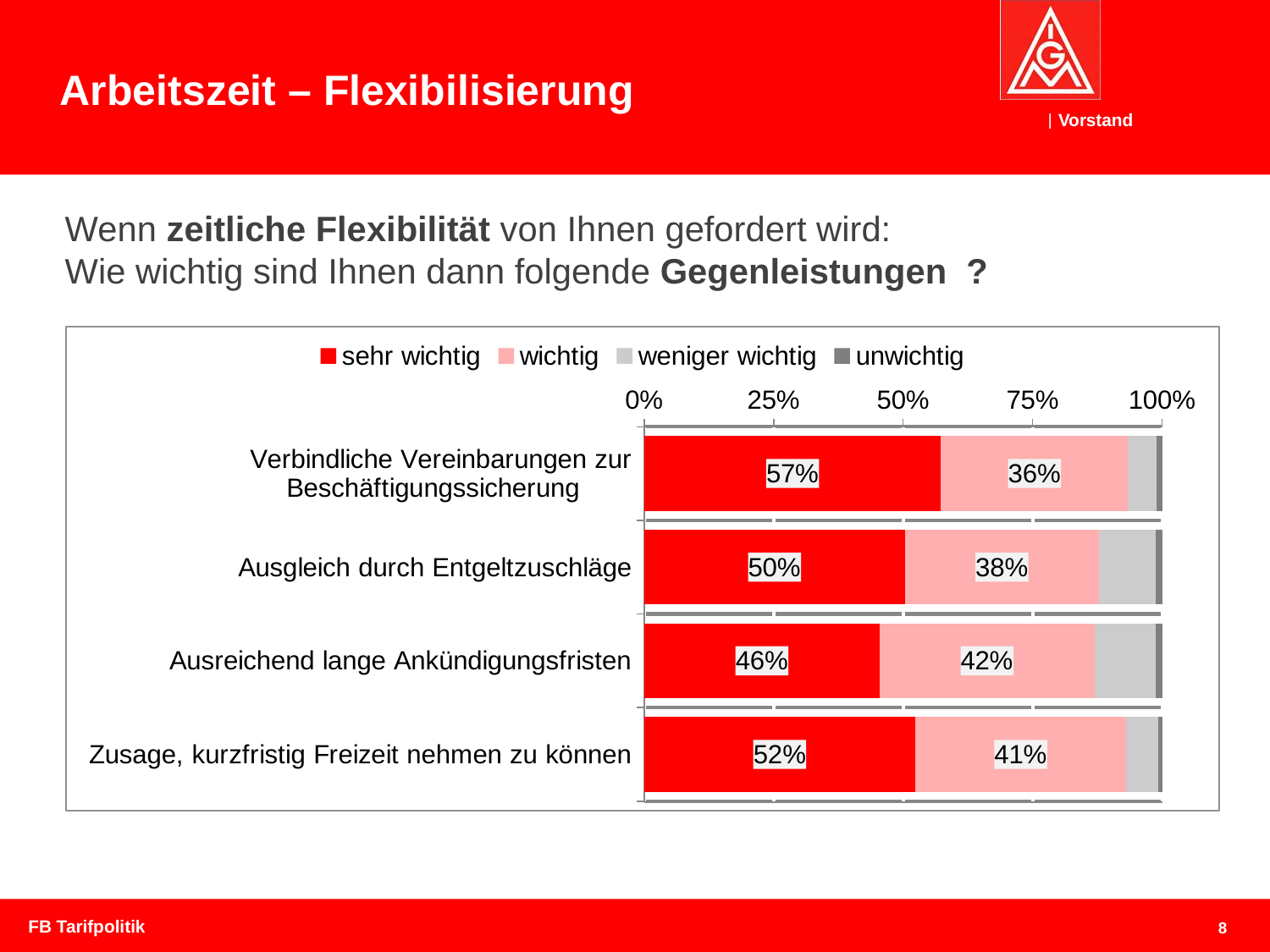
What is the 'sehr wichtig' value for 'Zusage, kurzfristig Freizeit nehmen zu können'? 52% What is the 'wichtig' value for 'Ausreichend lange Ankündigungsfristen'? 42% What is the 'wichtig' value for 'Ausgleich durch Entgeltzuschläge'? 38% What is the 'sehr wichtig' value for 'Verbindliche Vereinbarungen zur Beschäftigungssicherung'? 57% How many categories are shown in the chart? 4 What kind of chart is shown on the slide? Stacked bar chart Which is larger: the 'sehr wichtig' value for 'Ausgleich durch Entgeltzuschläge' or for 'Ausreichend lange Ankündigungsfristen'? Ausgleich durch Entgeltzuschläge Which category has the lowest 'sehr wichtig' value? Ausreichend lange Ankündigungsfristen Is the 'sehr wichtig' value for 'Ausreichend lange Ankündigungsfristen' greater or less than 50%? less What is the difference between the 'sehr wichtig' and 'wichtig' values for 'Verbindliche Vereinbarungen zur Beschäftigungssicherung'? 21% How many series does the legend list? 4 Which category has the highest 'sehr wichtig' value? Verbindliche Vereinbarungen zur Beschäftigungssicherung